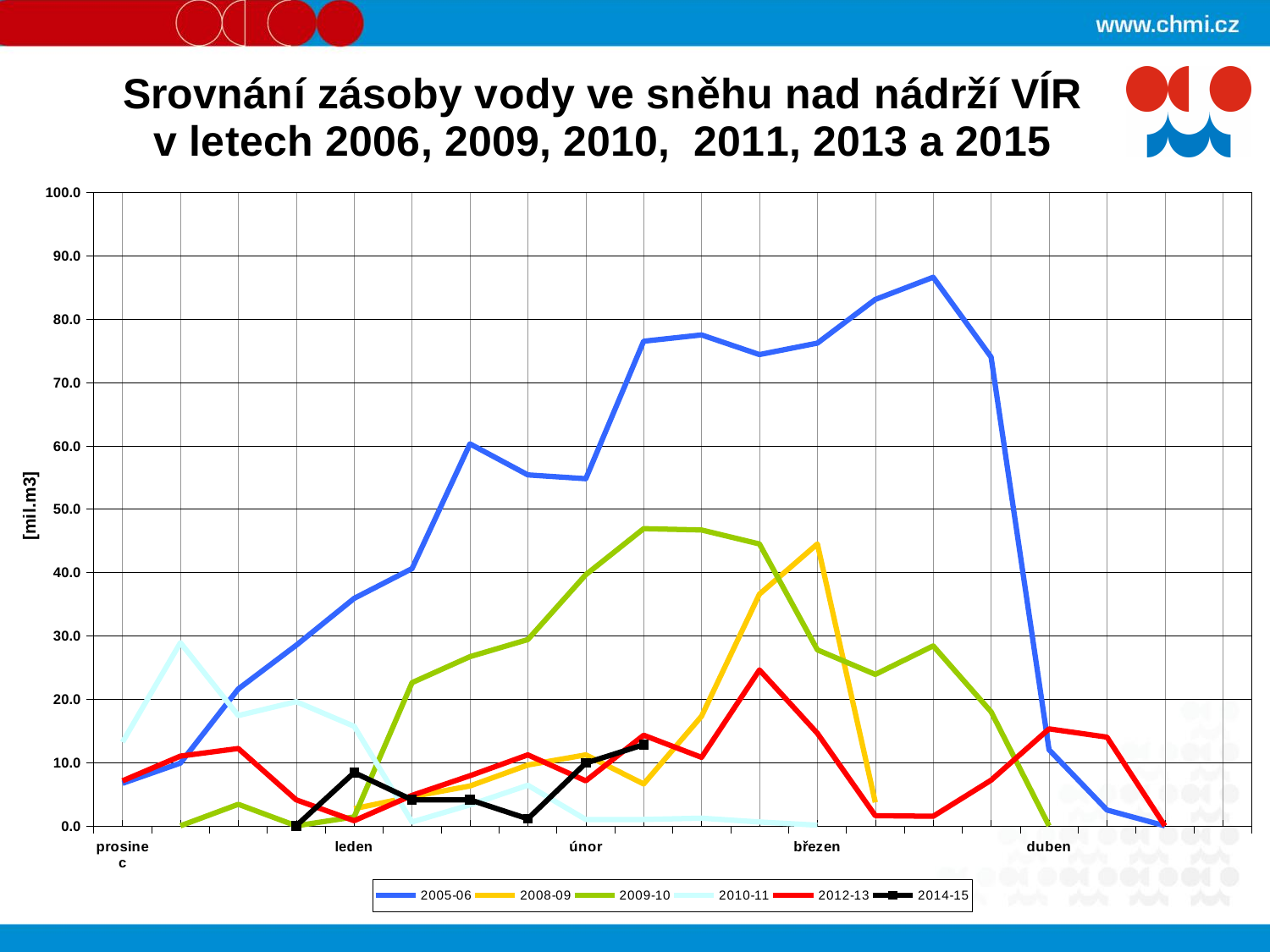
Is the peak value of the 2009-10 series greater or less than 50? less Is the peak value of the 2012-13 series greater or less than 30? less Is the peak value of the 2010-11 series greater or less than 20? greater How many series does the legend list? 6 Which series has the highest value at prosinec? 2010-11 Which series reaches the highest value on the chart? 2005-06 What kind of chart is shown on the slide? line chart What unit is shown on the y-axis label? [mil.m3] Does the 2005-06 series rise or fall between prosinec and únor? rise